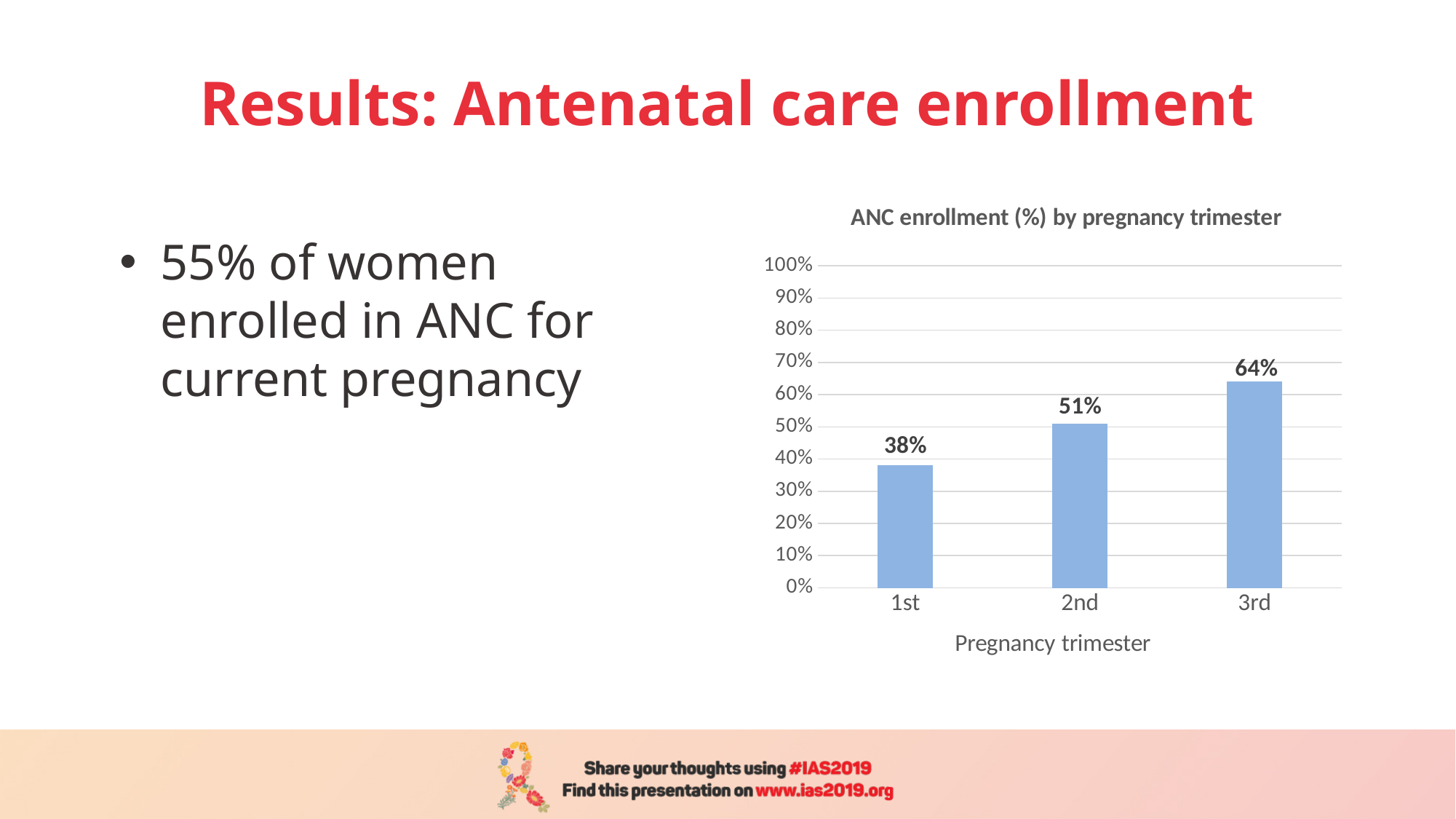
What is the ANC enrollment value for the 2nd trimester? 51% What is the difference in ANC enrollment between the 2nd and 1st trimesters? 13% Does ANC enrollment rise or fall from the 1st to the 3rd trimester? Rise How many pregnancy trimester categories are shown in the chart? 3 Which pregnancy trimester has the highest ANC enrollment? 3rd What kind of chart is used to show ANC enrollment by pregnancy trimester? Bar chart Which has a higher ANC enrollment, the 2nd trimester or the 3rd trimester? 3rd What is the difference in ANC enrollment between the 3rd and 1st trimesters? 26% Which pregnancy trimester has the lowest ANC enrollment? 1st What is the ANC enrollment value for the 1st trimester? 38% What is the ANC enrollment value for the 3rd trimester? 64% Is the ANC enrollment value for the 1st trimester greater or less than 40%? less